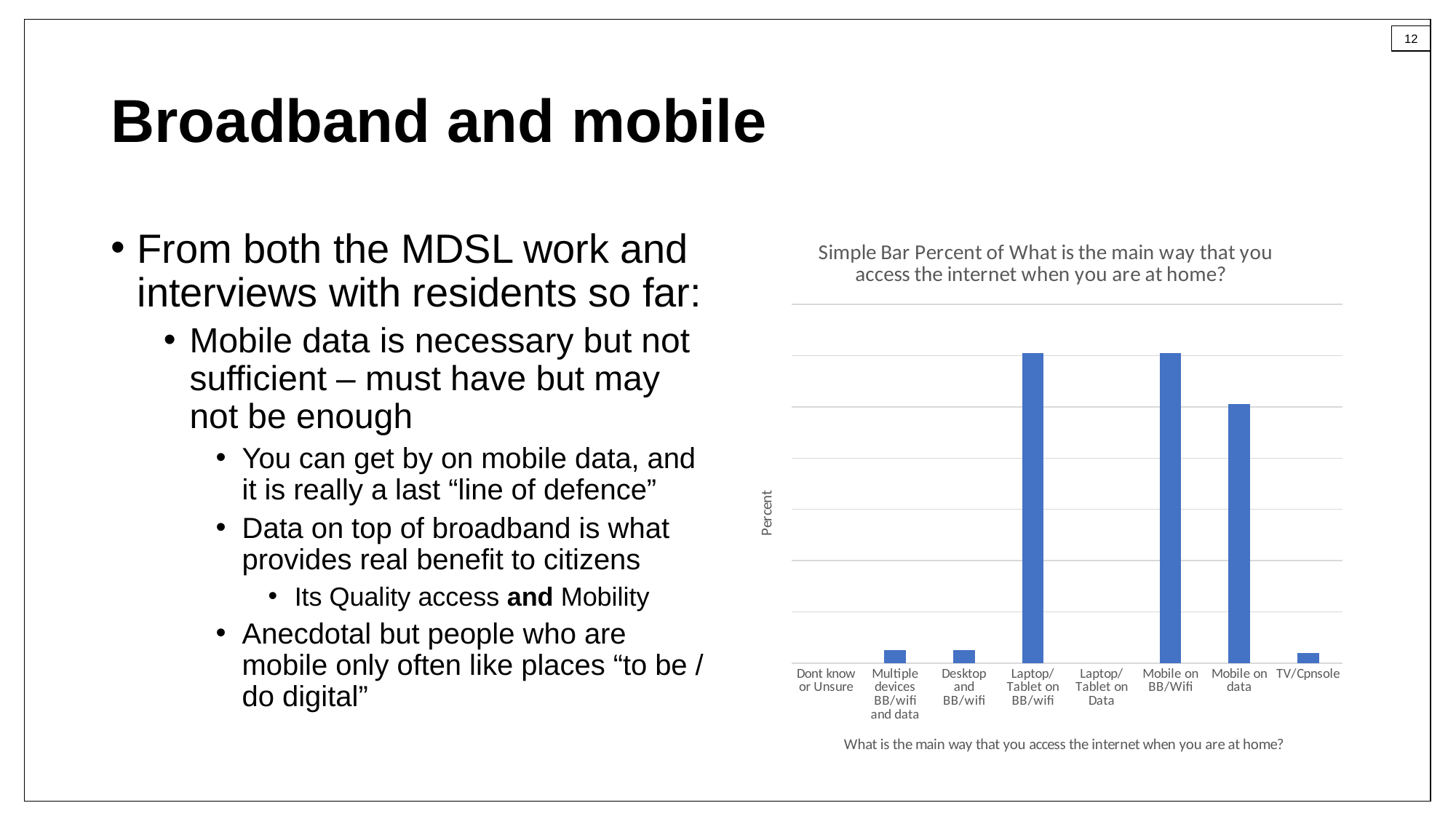
What kind of chart is shown on the slide? Bar chart Which is larger, the value for Mobile on BB/Wifi or the value for Mobile on data? Mobile on BB/Wifi Which is larger, the value for Laptop/Tablet on BB/wifi or the value for TV/Cpnsole? Laptop/Tablet on BB/wifi What is the label on the vertical axis of the chart? Percent Which is larger, the value for Multiple devices BB/wifi and data or the value for Mobile on BB/Wifi? Mobile on BB/Wifi How many categories are shown on the x axis of the chart? 8 What is the title of the chart? Simple Bar Percent of What is the main way that you access the internet when you are at home?